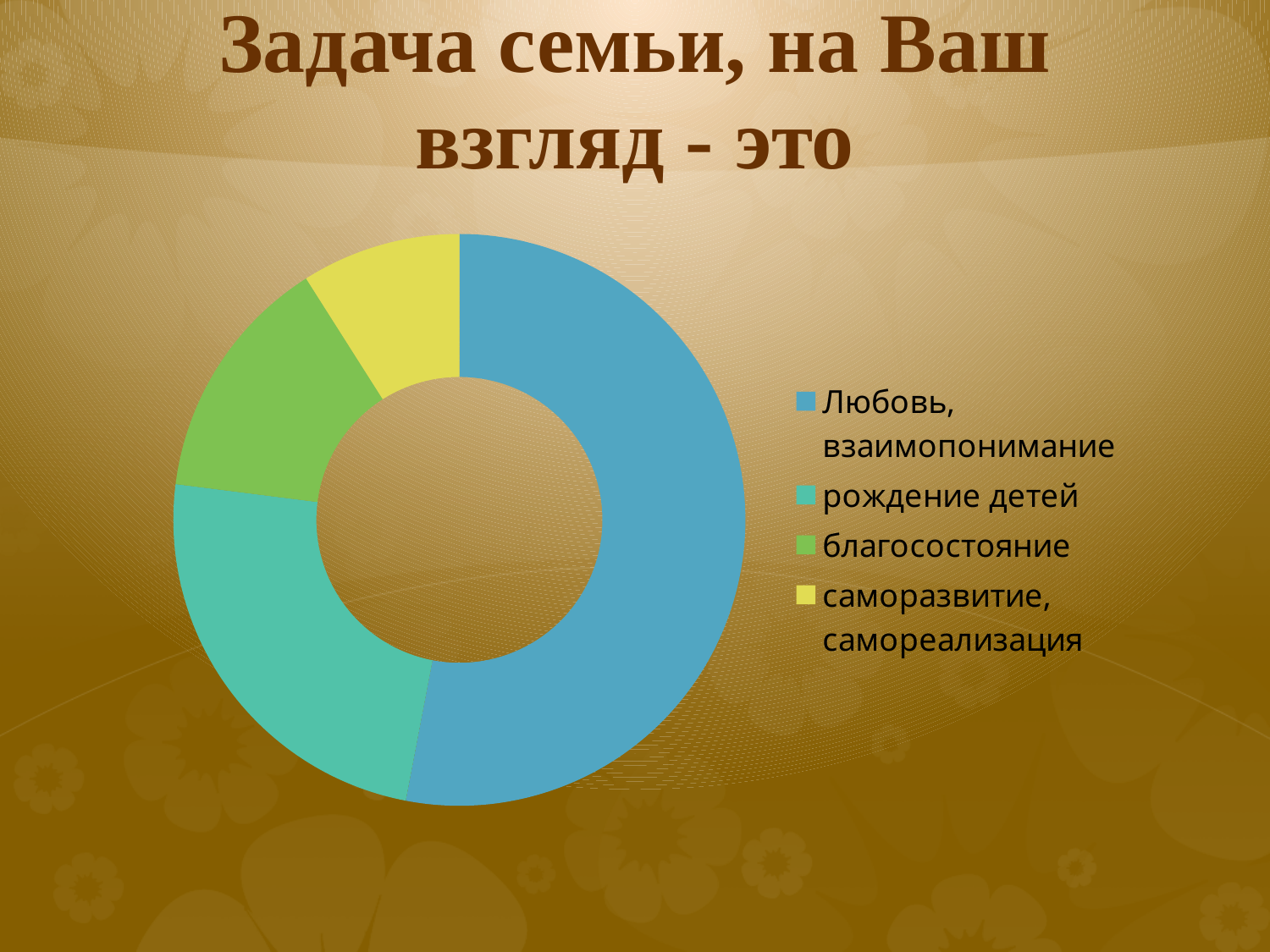
Which has the larger share: благосостояние or саморазвитие, самореализация? благосостояние Which category has the largest share of the chart? Любовь, взаимопонимание How many categories does the chart show? 4 Which colour represents рождение детей in the legend? teal (green-blue) What is the title of the slide containing the chart? Задача семьи, на Ваш взгляд - это Which category has the smallest share of the chart? саморазвитие, самореализация Does the category Любовь, взаимопонимание take up more or less than half of the chart? more What kind of chart is shown on the slide? doughnut chart Which has the larger share: рождение детей or благосостояние? рождение детей